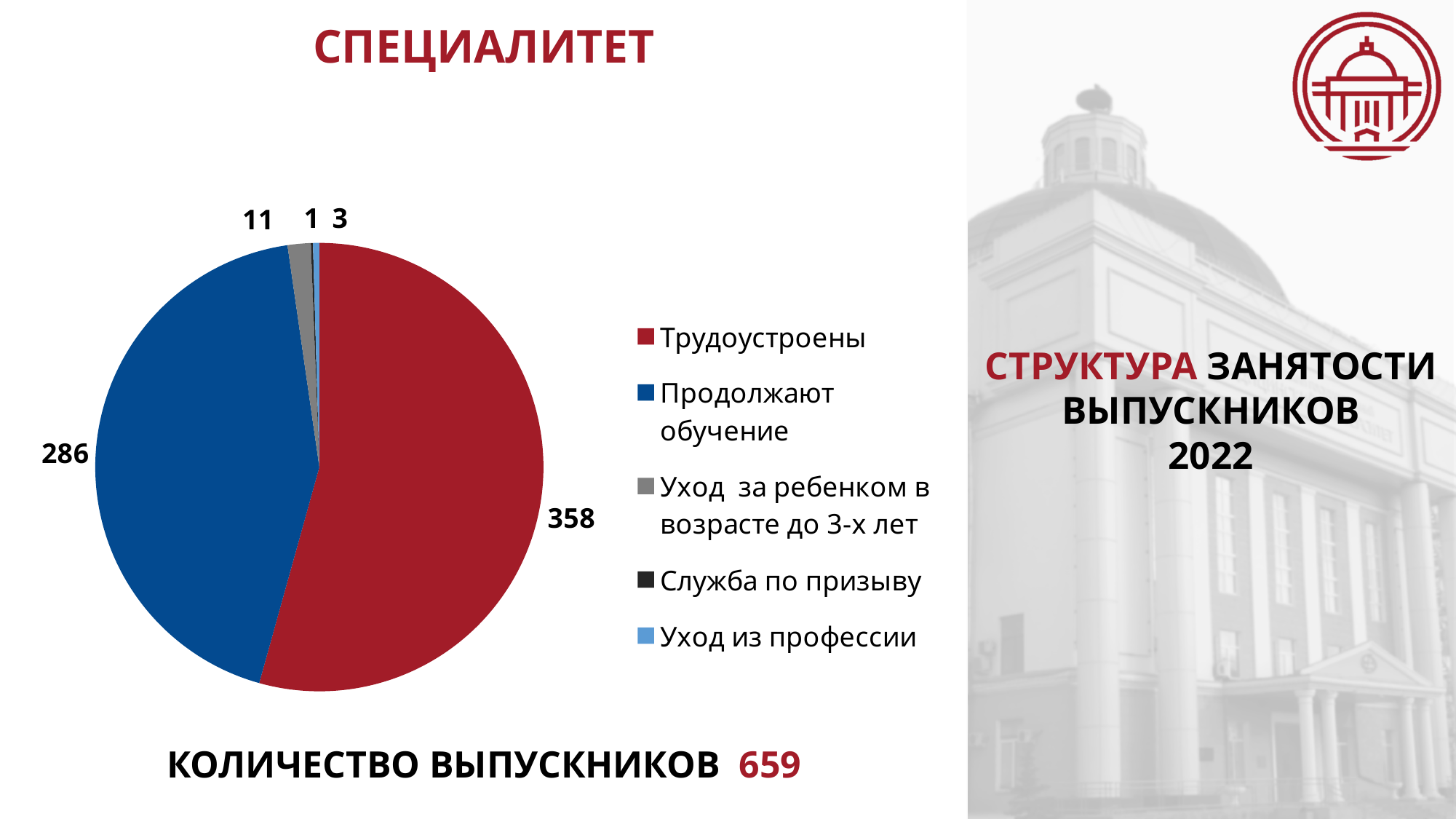
What is the value for "Уход за ребенком в возрасте до 3-х лет"? 11 What total number of graduates is stated below the chart? 659 What kind of chart is shown on the slide? pie chart Which category has the largest slice of the pie? Трудоустроены Which category has the smallest slice of the pie? Служба по призыву How many graduates are in the "Трудоустроены" slice? 358 What is the difference between the "Трудоустроены" and "Продолжают обучение" values? 72 What is the value for "Продолжают обучение"? 286 Which is larger: "Уход из профессии" or "Служба по призыву"? Уход из профессии What is the value for "Служба по призыву"? 1 What is the value for "Уход из профессии"? 3 How many categories does the pie chart have? 5